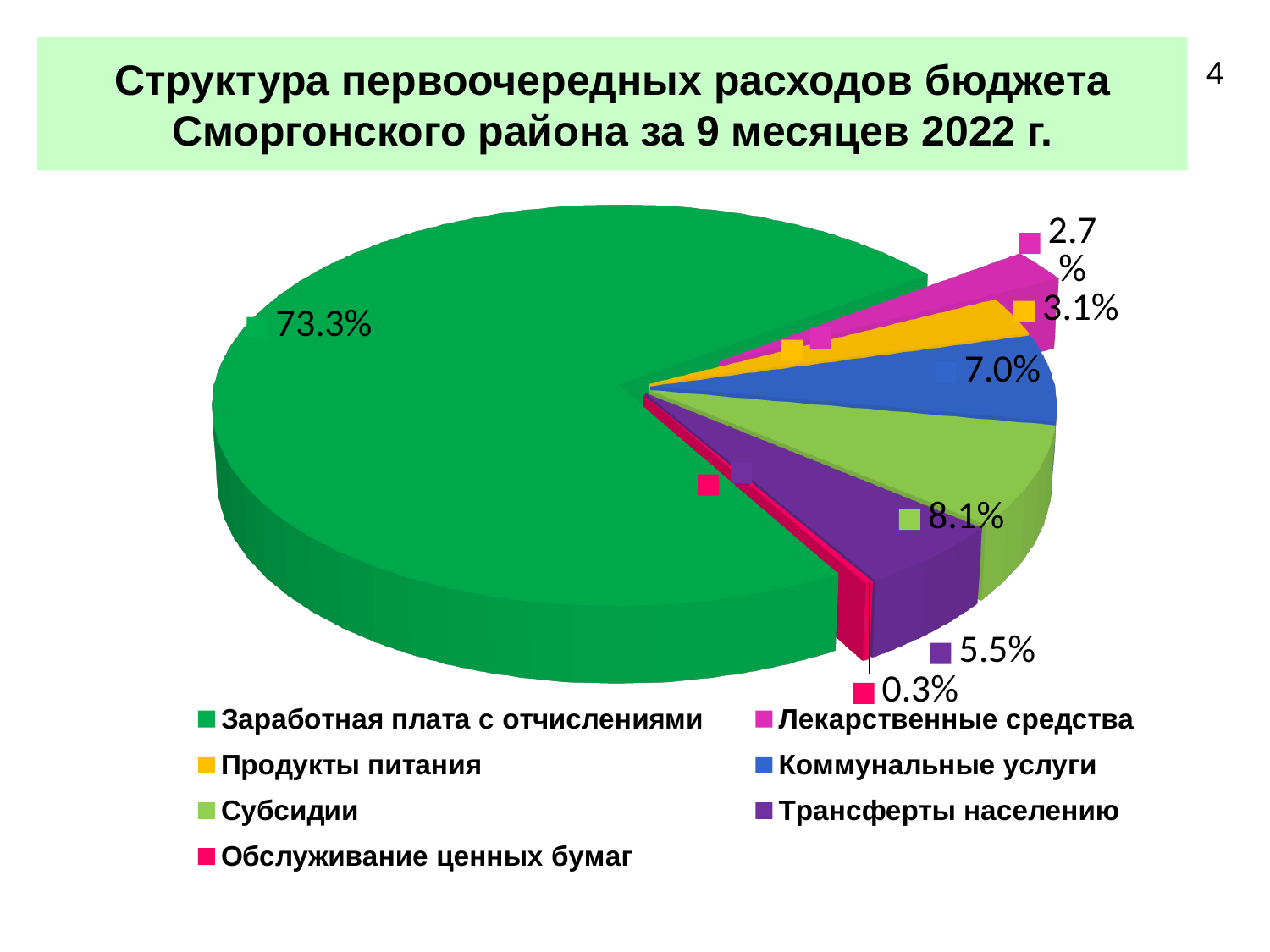
What is the title of the chart? Структура первоочередных расходов бюджета Сморгонского района за 9 месяцев 2022 г. Which category has the largest share of the pie? Заработная плата с отчислениями Which is larger: the share for 'Продукты питания' or for 'Лекарственные средства'? Продукты питания What share of the pie does 'Заработная плата с отчислениями' have? 73.3% What is the value shown for 'Коммунальные услуги'? 7.0% What is the value shown for 'Трансферты населению'? 5.5% What is the value shown for 'Обслуживание ценных бумаг'? 0.3% How many categories does the legend list? 7 What is the value shown for 'Субсидии'? 8.1% What is the difference between the shares of 'Субсидии' and 'Коммунальные услуги'? 1.1% Which category has the smallest share of the pie? Обслуживание ценных бумаг What type of chart is shown on the slide? Pie chart